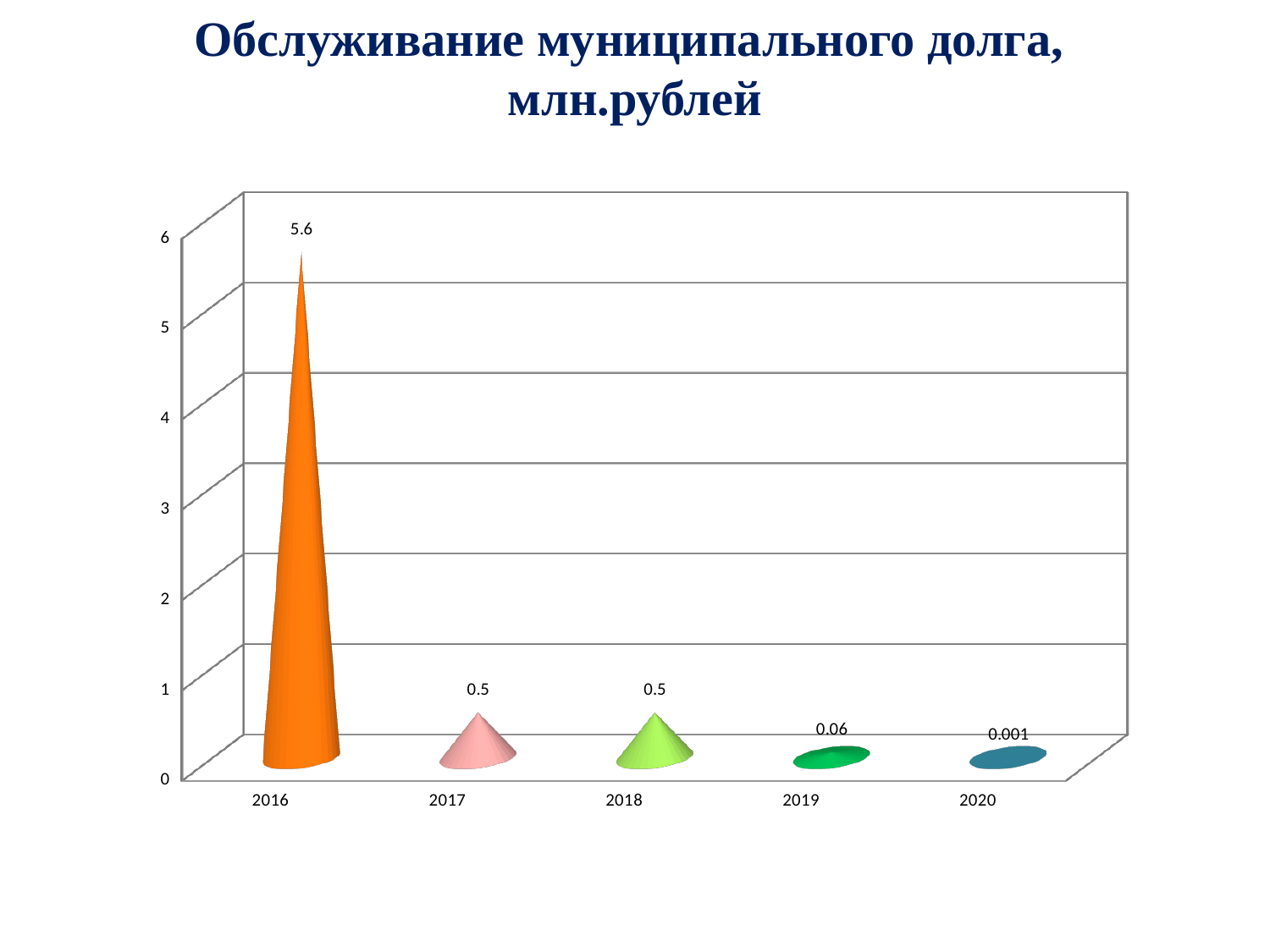
What is the value for 2017? 0.5 How many years are shown on the x axis? 5 Which year has the highest value? 2016 What is the difference between the values for 2016 and 2018? 5.1 What is the value for 2020? 0.001 What is the value for 2019? 0.06 Do the values rise or fall from 2016 to 2020? fall Which year has the lowest value? 2020 What is the value for 2016? 5.6 What is the difference between the values for 2019 and 2020? 0.059 Which is larger, the value for 2018 or the value for 2019? 2018 What is the title of the chart? Обслуживание муниципального долга, млн.рублей